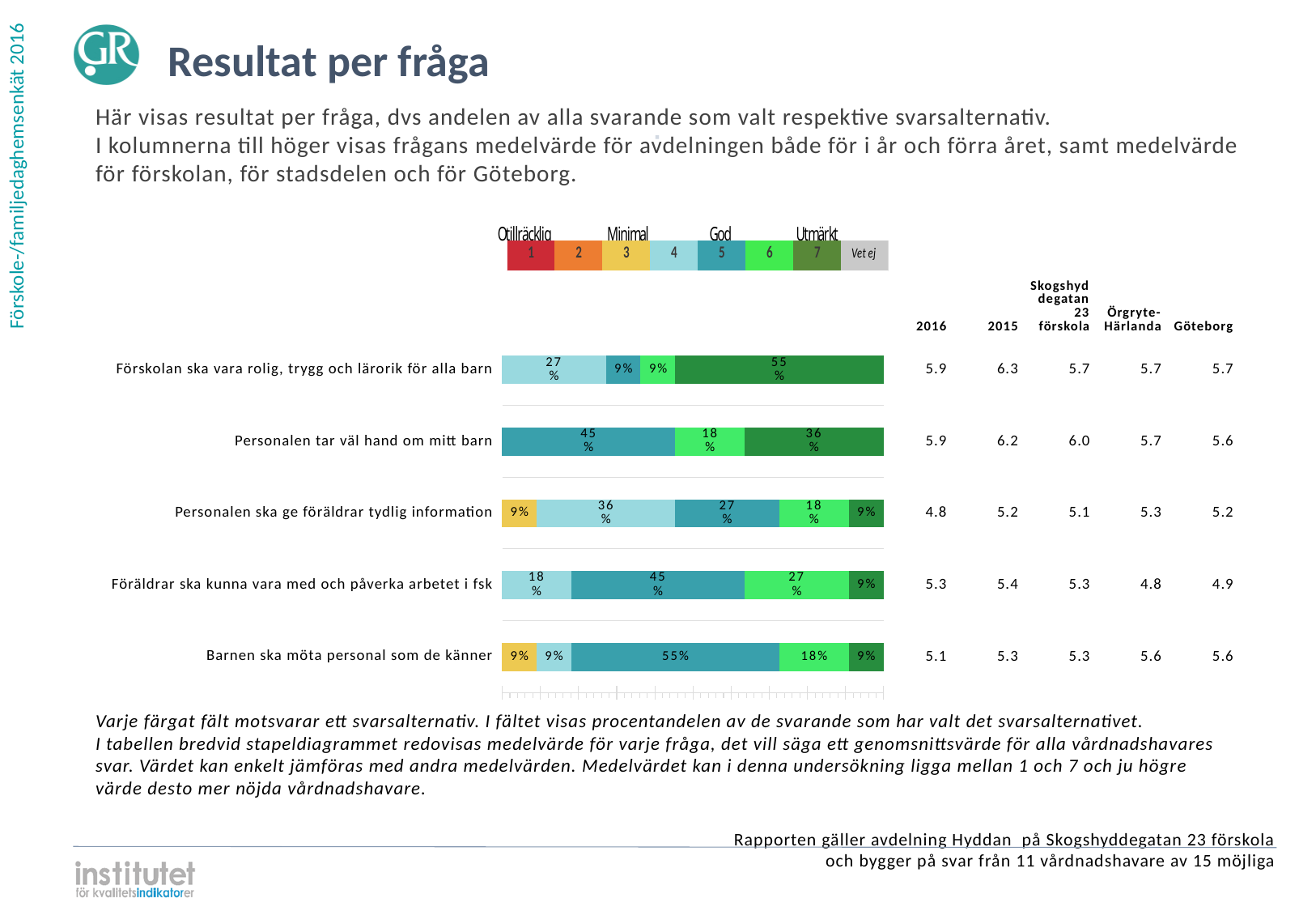
What percentage of respondents chose answer 7 (Utmärkt) for 'Förskolan ska vara rolig, trygg och lärorik för alla barn'? 55% What is the 2016 mean value for 'Personalen ska ge föräldrar tydlig information'? 4.8 Which colour represents answer alternative 7 (Utmärkt) in the legend? Dark green For 'Personalen tar väl hand om mitt barn', which is larger: the share for answer 6 or the share for answer 7? Answer 7 What is the combined share of answers 6 and 7 for 'Personalen ska ge föräldrar tydlig information'? 27% How many answer alternatives does the legend above the chart list? 8 What is the difference between the share for answer 5 and the share for answer 7 in 'Föräldrar ska kunna vara med och påverka arbetet i fsk'? 36% What percentage chose answer 4 for 'Personalen ska ge föräldrar tydlig information'? 36% What percentage chose answer 5 for 'Personalen tar väl hand om mitt barn'? 45% Which answer alternative has the largest share for 'Barnen ska möta personal som de känner'? 5 How many questions (categories) are shown in the bar chart? 5 What kind of chart is used to show the results per question? Stacked bar chart